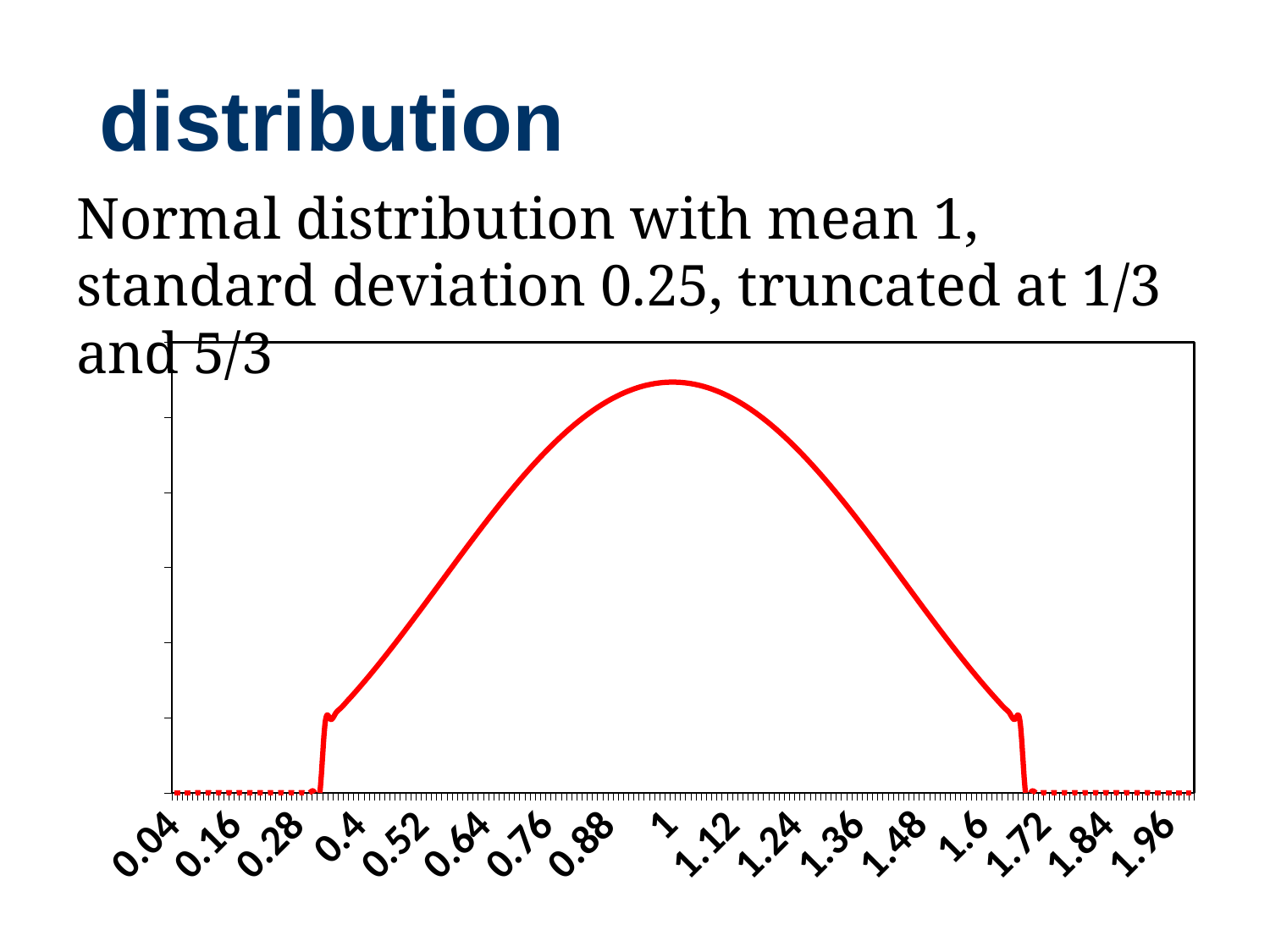
Is the plotted value at x = 0.64 larger or smaller than the value at x = 1? smaller How many labels are printed along the x axis? 17 At which x-axis label does the plotted curve reach its highest value? 1 Does the curve rise or fall as x increases from 0.4 to 1? rise Is the plotted value at x = 0.88 larger or smaller than the value at x = 1.48? larger What kind of chart is shown on the slide? line chart Is the plotted value at x = 0.16 larger or smaller than the value at x = 0.52? smaller What is the first label printed on the x axis? 0.04 Does the curve rise or fall as x increases from 1 to 1.6? fall What is the last label printed on the x axis? 1.96